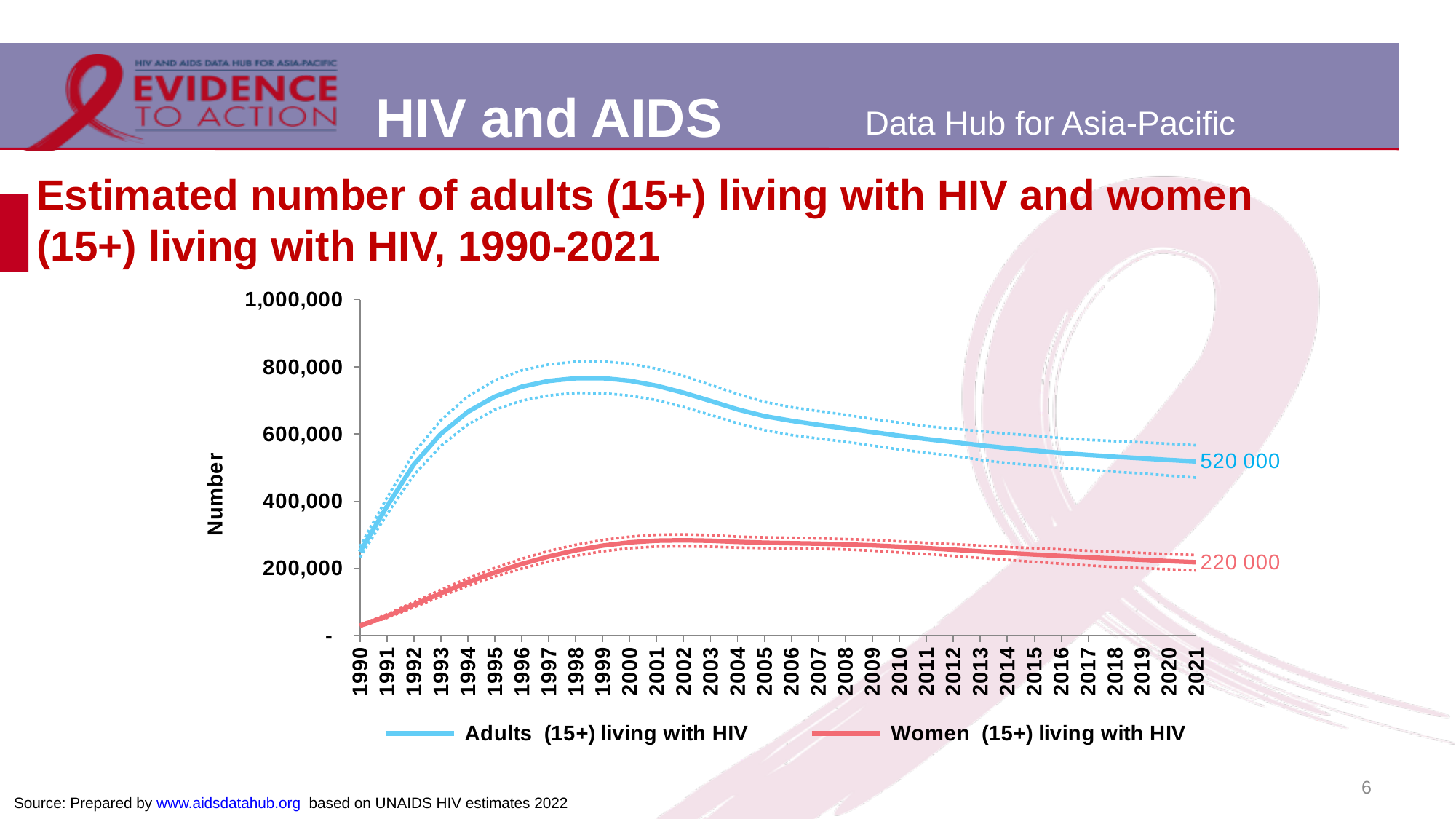
What is the estimated number of women (15+) living with HIV in 2021? 220 000 What kind of chart is shown on the slide? line chart What is the estimated number of adults (15+) living with HIV in 2021? 520 000 Is the value for Adults (15+) living with HIV in 1990 greater or less than 400,000? less In which year is the number of women (15+) living with HIV lowest? 1990 In 2021, which series has the larger value: Adults (15+) living with HIV or Women (15+) living with HIV? Adults (15+) living with HIV How many series does the legend list? 2 What is the difference between the number of adults (15+) living with HIV and the number of women (15+) living with HIV in 2021? 300 000 Does the number of adults (15+) living with HIV rise or fall between 1999 and 2021? fall Is the value for Women (15+) living with HIV in 1990 greater or less than 200,000? less How many years are shown on the x axis of the chart? 32 Is the value for Adults (15+) living with HIV in 1999 greater or less than 600,000? greater